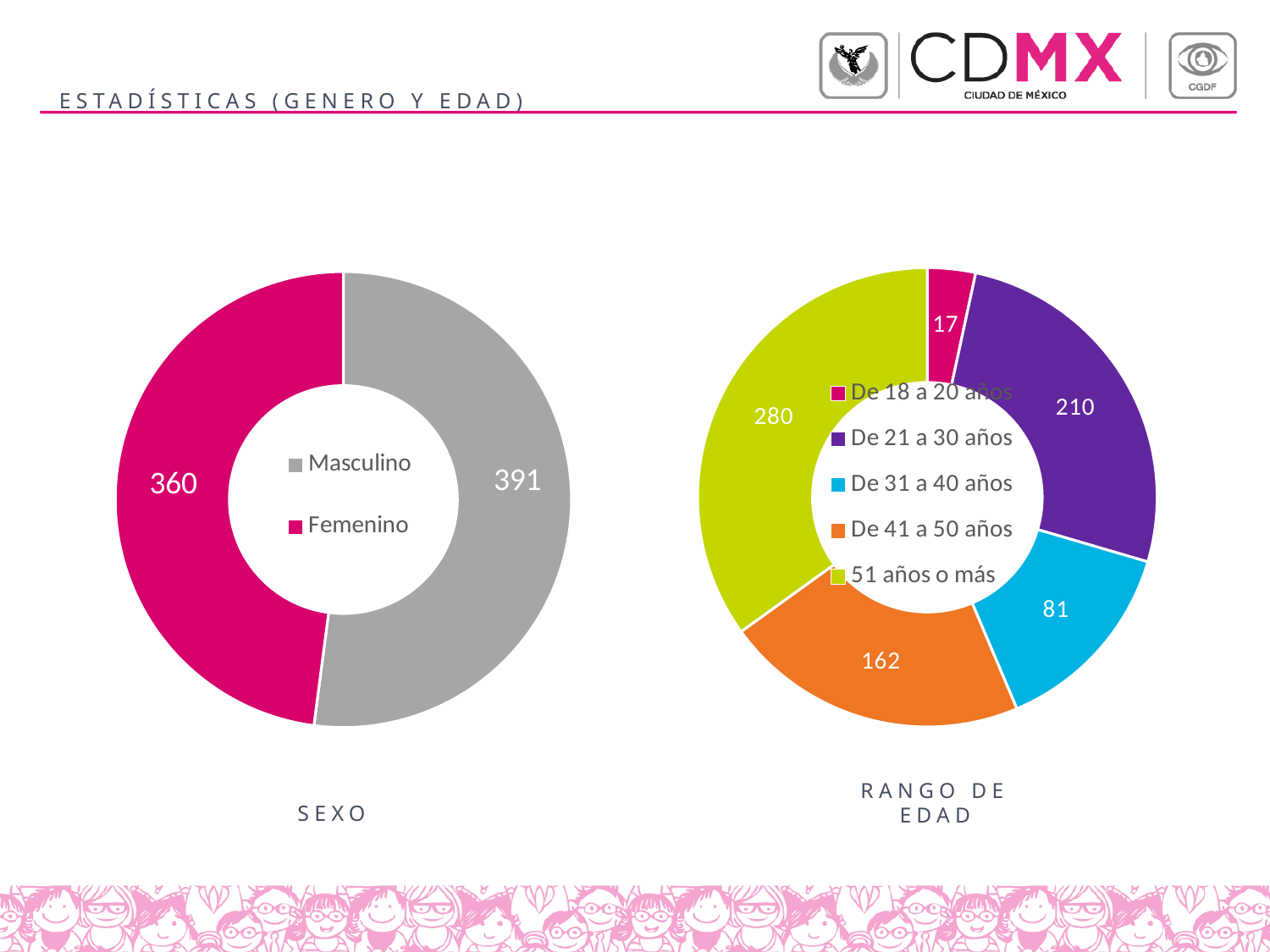
In the RANGO DE EDAD chart, which age range has the lowest value? De 18 a 20 años In the SEXO chart, how many categories does the legend list? 2 In the RANGO DE EDAD chart, what is the value for De 31 a 40 años? 81 In the SEXO chart, what is the value for Masculino? 391 In the SEXO chart, which category has the larger value, Masculino or Femenino? Masculino In the SEXO chart, what is the difference between the Masculino and Femenino values? 31 What kind of chart is the RANGO DE EDAD chart? Pie chart (doughnut) In the RANGO DE EDAD chart, which age range has the highest value? 51 años o más In the RANGO DE EDAD chart, what is the difference between the values for 51 años o más and De 41 a 50 años? 118 In the RANGO DE EDAD chart, what is the value for De 21 a 30 años? 210 In the RANGO DE EDAD chart, how many age ranges are shown? 5 In the SEXO chart, what is the value for Femenino? 360